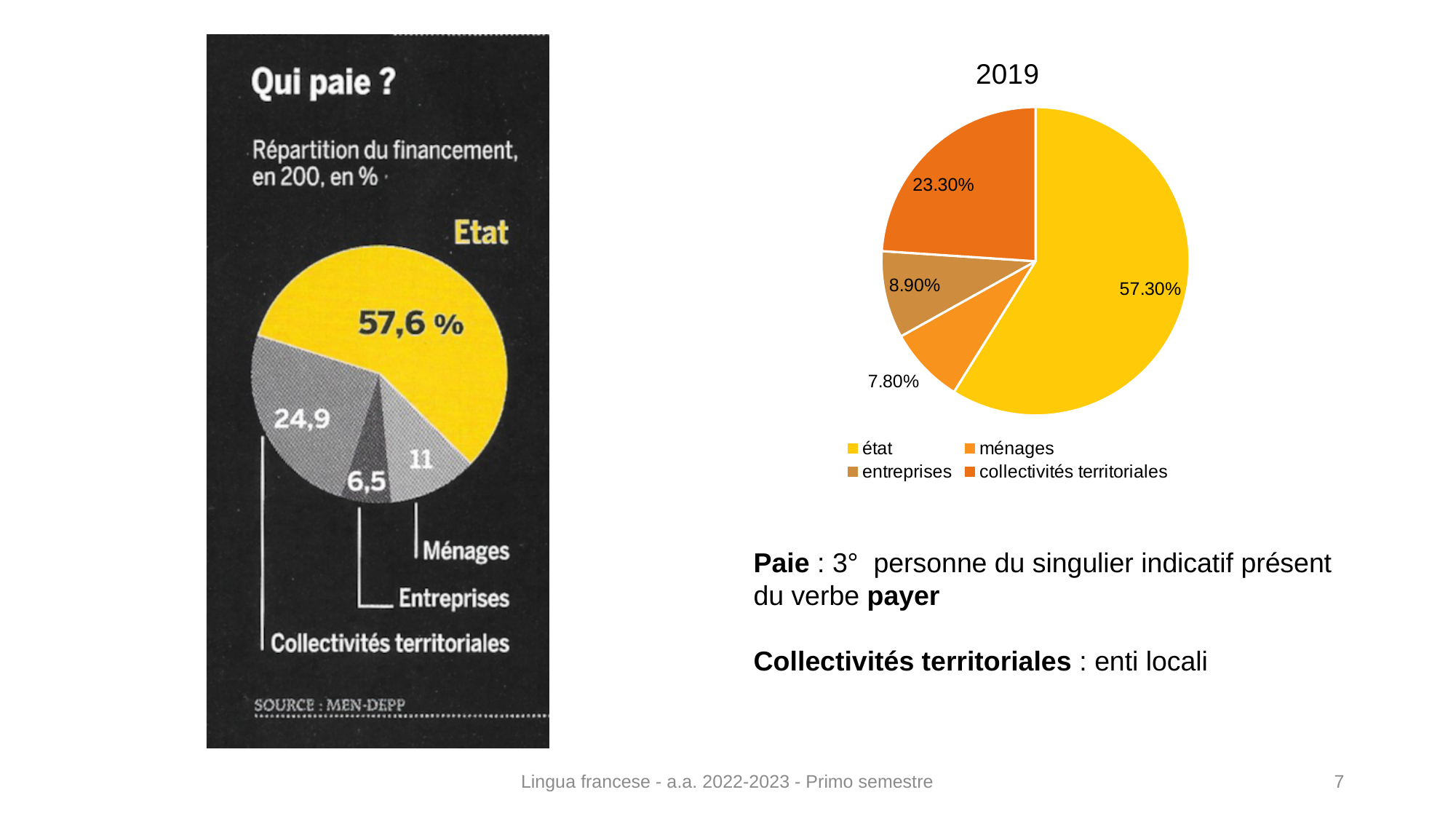
In the pie chart titled "2019", what is the value for état? 57.30% In the pie chart titled "2019", what is the difference between the shares of état and collectivités territoriales? 34.00% In the chart titled "Qui paie ?" on the left, what is the value for Collectivités territoriales? 24,9 In the pie chart titled "2019", how many categories does the legend list? 4 In the pie chart titled "2019", which colour represents état? Yellow In the pie chart titled "2019", which category has the largest share? état In the chart titled "Qui paie ?" on the left, which is larger, Ménages or Entreprises? Ménages In the pie chart titled "2019", which category has the smallest share? ménages In the chart titled "Qui paie ?" on the left, what is the value for Etat? 57,6 % In the pie chart titled "2019", what is the value for ménages? 7.80% What kind of chart is the chart titled "Qui paie ?" on the left? Pie chart In the pie chart titled "2019", what is the value for collectivités territoriales? 23.30%